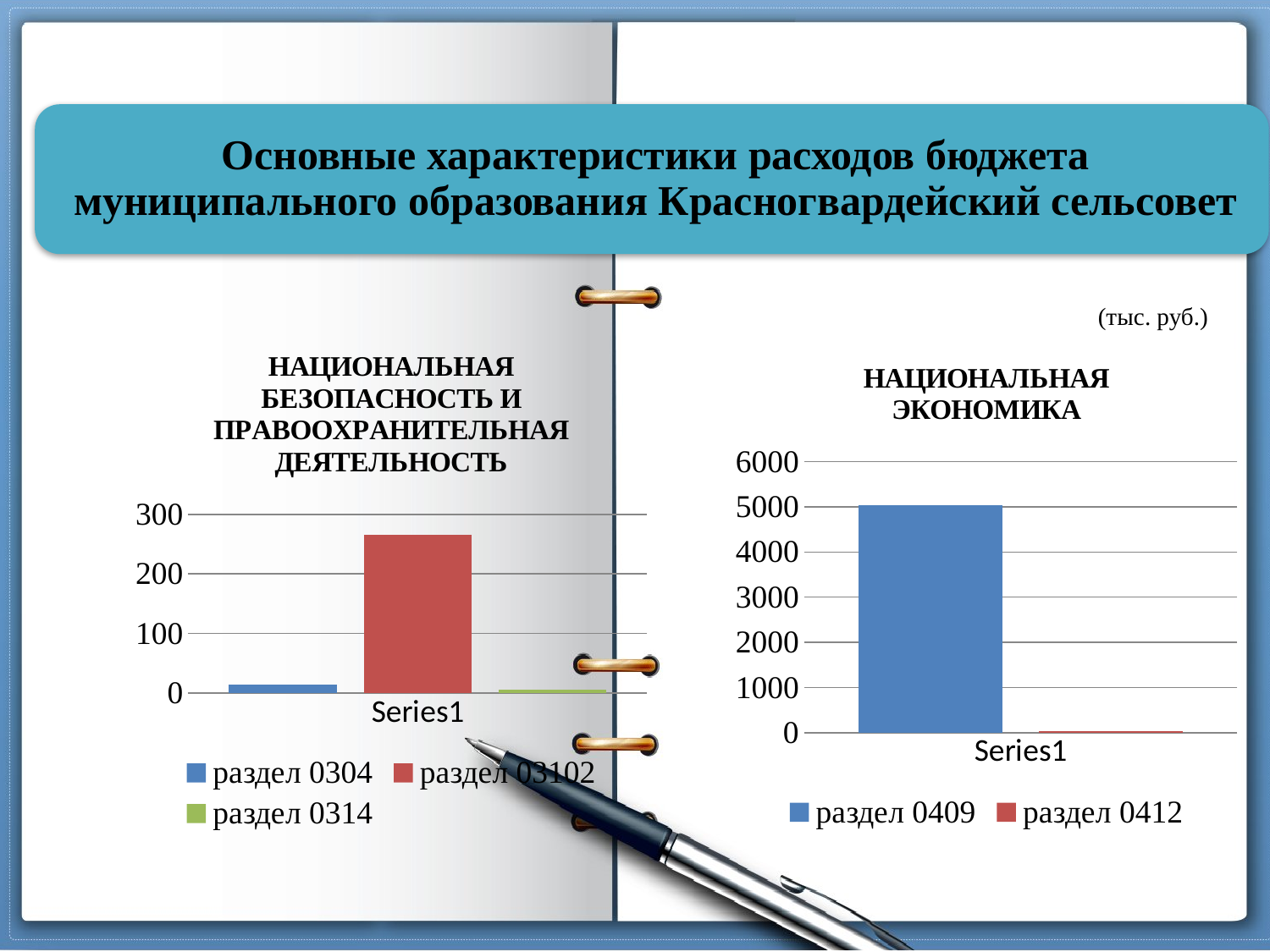
In the left chart (НАЦИОНАЛЬНАЯ БЕЗОПАСНОСТЬ И ПРАВООХРАНИТЕЛЬНАЯ ДЕЯТЕЛЬНОСТЬ), which series has the lowest value? раздел 0314 In the right chart (НАЦИОНАЛЬНАЯ ЭКОНОМИКА), which is larger: раздел 0409 or раздел 0412? раздел 0409 In the right chart (НАЦИОНАЛЬНАЯ ЭКОНОМИКА), is the value for раздел 0409 greater or less than 4000? greater In the left chart (НАЦИОНАЛЬНАЯ БЕЗОПАСНОСТЬ И ПРАВООХРАНИТЕЛЬНАЯ ДЕЯТЕЛЬНОСТЬ), how many series does the legend list? 3 In the left chart (НАЦИОНАЛЬНАЯ БЕЗОПАСНОСТЬ И ПРАВООХРАНИТЕЛЬНАЯ ДЕЯТЕЛЬНОСТЬ), is the value for раздел 03102 greater or less than 200? greater In the right chart (НАЦИОНАЛЬНАЯ ЭКОНОМИКА), how many series does the legend list? 2 In the right chart (НАЦИОНАЛЬНАЯ ЭКОНОМИКА), which series has the highest value? раздел 0409 What unit is indicated for the values on the slide? тыс. руб. What kind of chart is the left chart titled "НАЦИОНАЛЬНАЯ БЕЗОПАСНОСТЬ И ПРАВООХРАНИТЕЛЬНАЯ ДЕЯТЕЛЬНОСТЬ"? bar chart In the left chart (НАЦИОНАЛЬНАЯ БЕЗОПАСНОСТЬ И ПРАВООХРАНИТЕЛЬНАЯ ДЕЯТЕЛЬНОСТЬ), is the value for раздел 0304 greater or less than 100? less What kind of chart is the right chart titled "НАЦИОНАЛЬНАЯ ЭКОНОМИКА"? bar chart In the left chart (НАЦИОНАЛЬНАЯ БЕЗОПАСНОСТЬ И ПРАВООХРАНИТЕЛЬНАЯ ДЕЯТЕЛЬНОСТЬ), which series has the highest value? раздел 03102